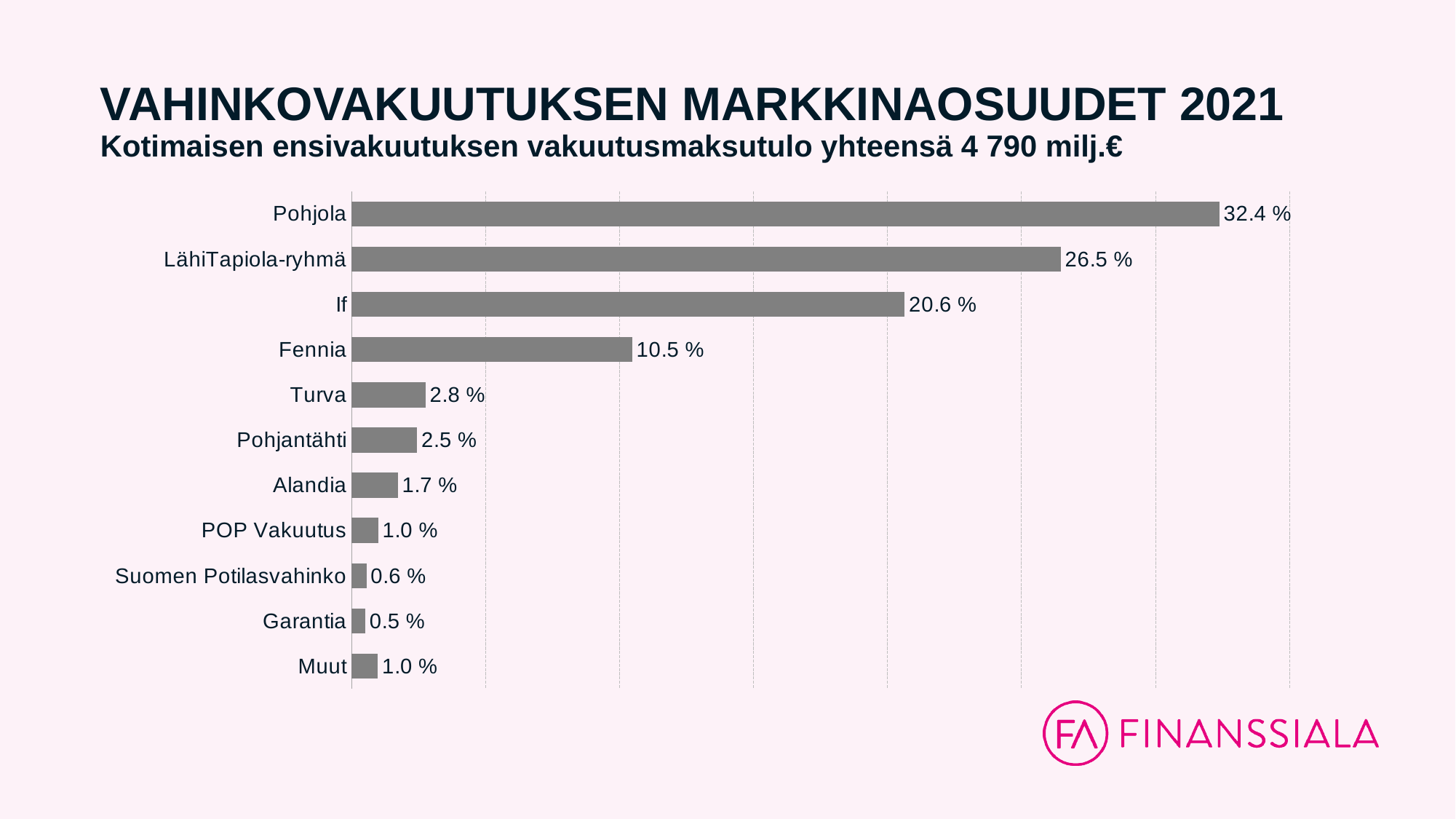
What is the market share shown for Alandia? 1.7 % What is the difference in market share between Pohjola and LähiTapiola-ryhmä? 5.9 % Which has a larger market share, Turva or Pohjantähti? Turva Which category has the highest market share? Pohjola What is the difference in market share between If and Fennia? 10.1 % Which category has the lowest market share? Garantia How many categories are shown in the chart? 11 What is the market share shown for Fennia? 10.5 % What kind of chart is shown on the slide? Bar chart What is the market share shown for Pohjola? 32.4 % What is the title of the chart on the slide? VAHINKOVAKUUTUKSEN MARKKINAOSUUDET 2021 What is the market share shown for Suomen Potilasvahinko? 0.6 %